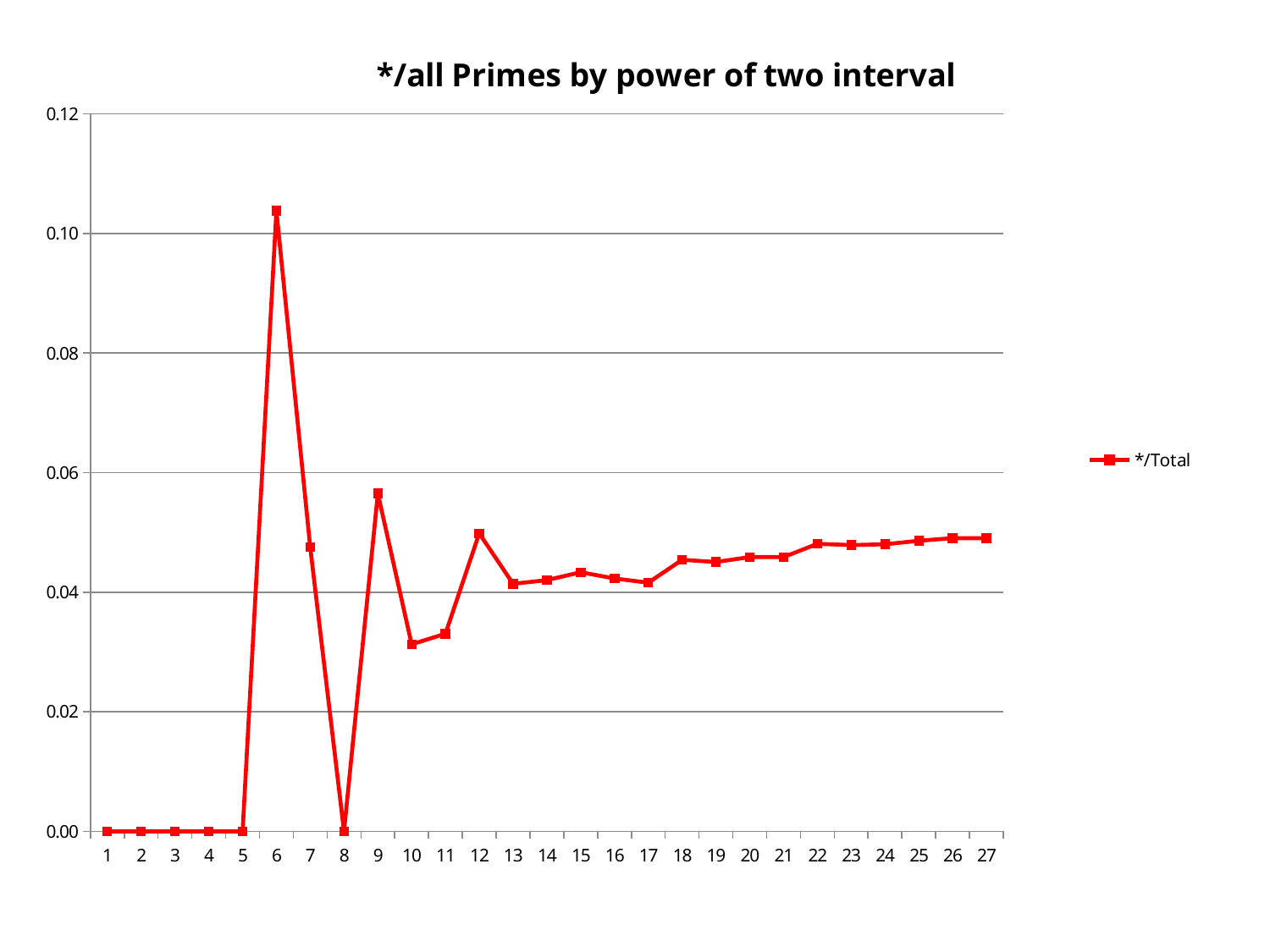
How many series does the legend list? 1 Do the values rise or fall from category 18 to category 27? rise Is the value for category 6 greater or less than 0.10? greater At which x-axis category does the */Total series reach its highest value? 6 What is the title of the chart? */all Primes by power of two interval Which has the larger value, category 9 or category 12? 9 What kind of chart is shown on the slide? line chart What is the value of */Total at category 3? 0.00 How many points are plotted along the x axis? 27 Is the value for category 10 greater or less than 0.04? less What is the value of */Total at category 8? 0.00 What is the name of the series shown in the legend? */Total